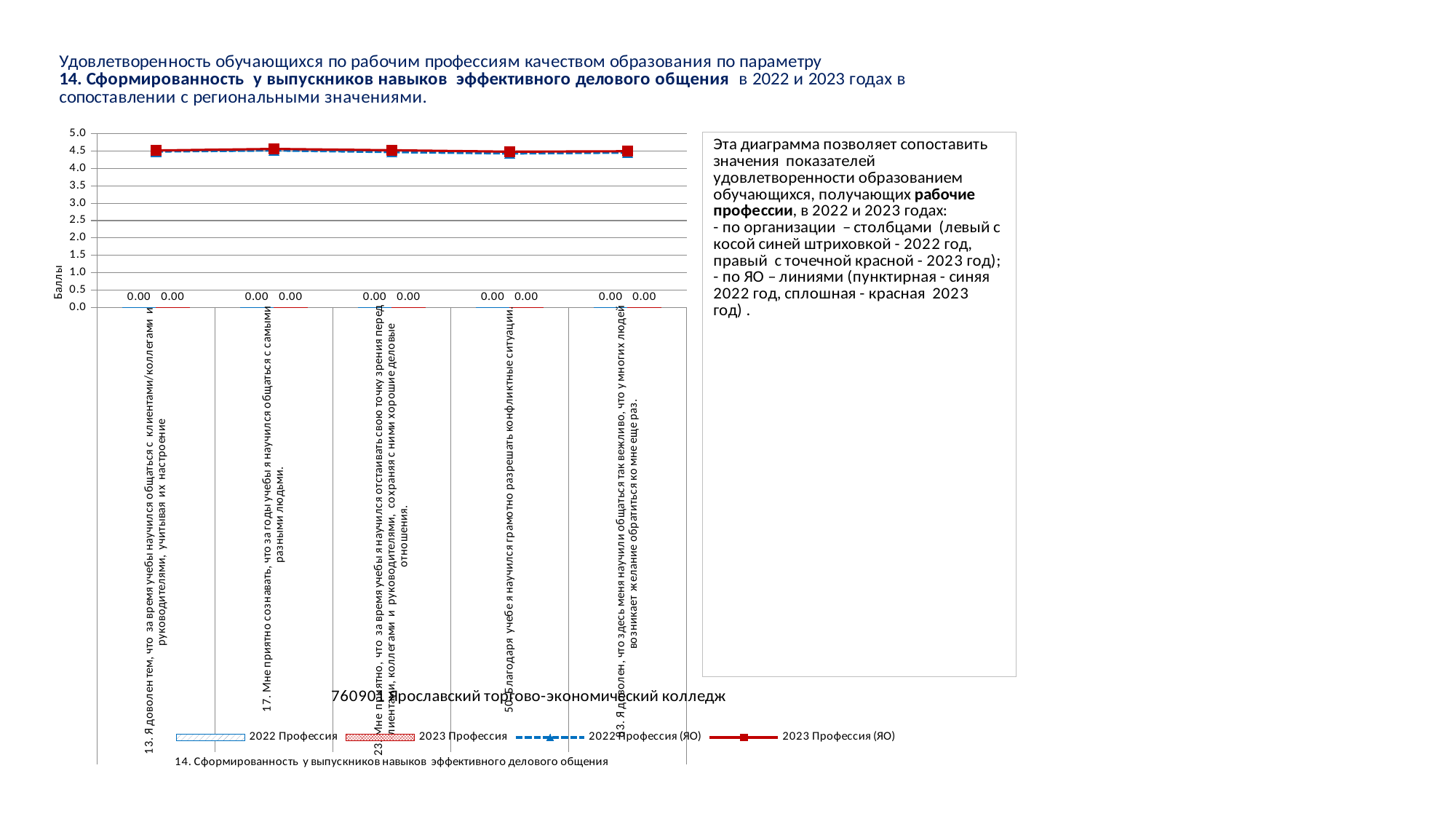
Is the value of the 2022 Профессия (ЯО) line for category 50 greater or less than 5.0? less Is the value of the 2023 Профессия (ЯО) line for category 13 greater or less than 3.0? greater How many categories (survey statements) are plotted along the x axis? 5 Is the value of the 2023 Профессия (ЯО) line for category 17 greater or less than 4.0? greater What is the value of the 2022 Профессия bar for category 13 (Я доволен тем, что за время учебы научился общаться с клиентами/коллегами и руководителями)? 0.00 What kind of chart is shown on the slide? Combined bar and line chart What is the label of the vertical axis? Баллы How many series does the legend list? 4 What is the value of the 2022 Профессия bar for category 50 (Благодаря учебе я научился грамотно разрешать конфликтные ситуации)? 0.00